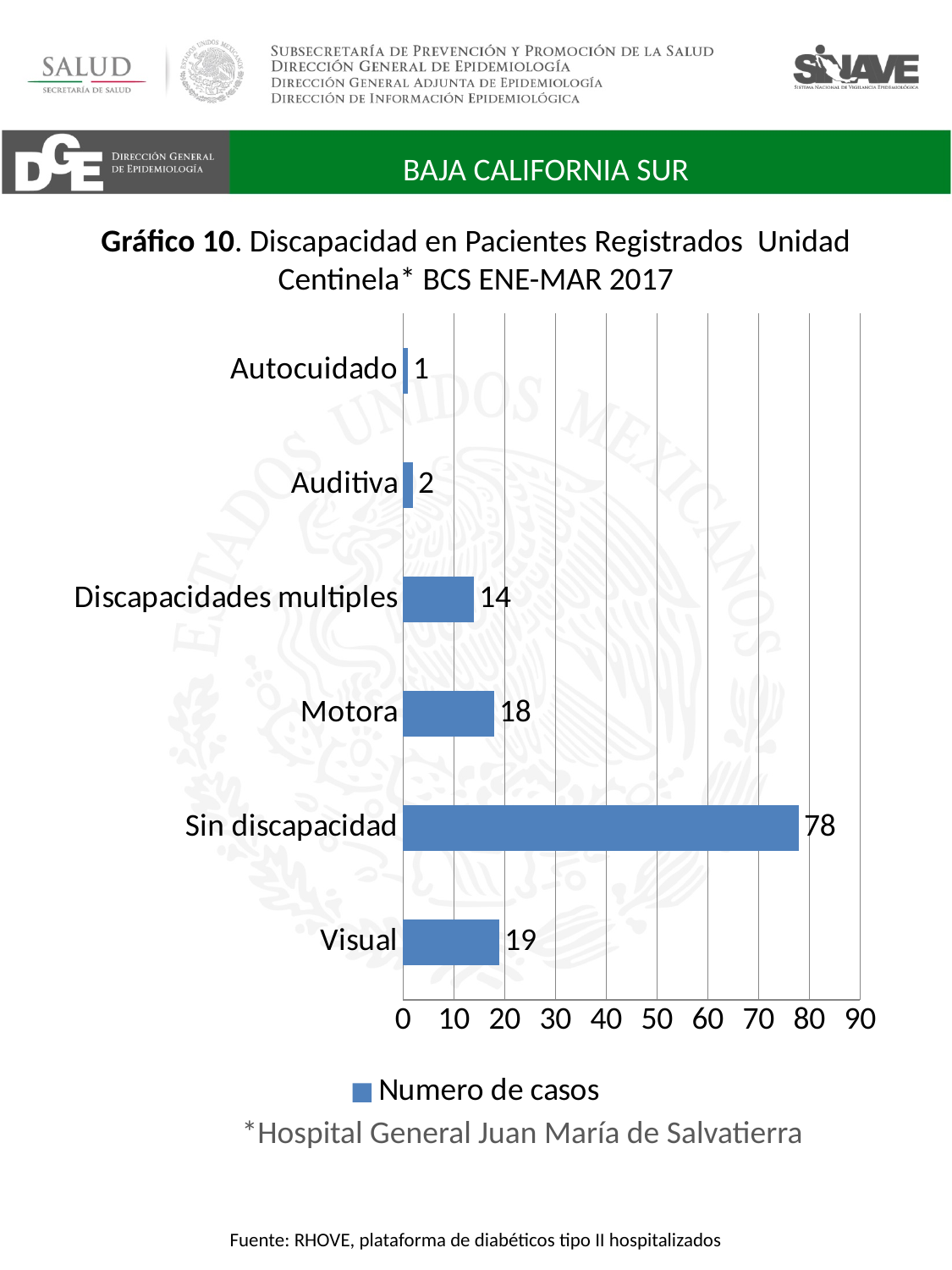
What is the number of cases for Motora? 18 What is the number of cases for Discapacidades multiples? 14 What kind of chart is shown on the slide? bar chart Which category has the lowest number of cases? Autocuidado Which category has the highest number of cases? Sin discapacidad Which has more cases, Motora or Discapacidades multiples? Motora How many categories are shown in the chart? 6 What is the difference in number of cases between Sin discapacidad and Visual? 59 What is the number of cases for Sin discapacidad? 78 What series name does the legend show? Numero de casos Is the value for Sin discapacidad greater or less than 70? greater What is the number of cases for Visual? 19